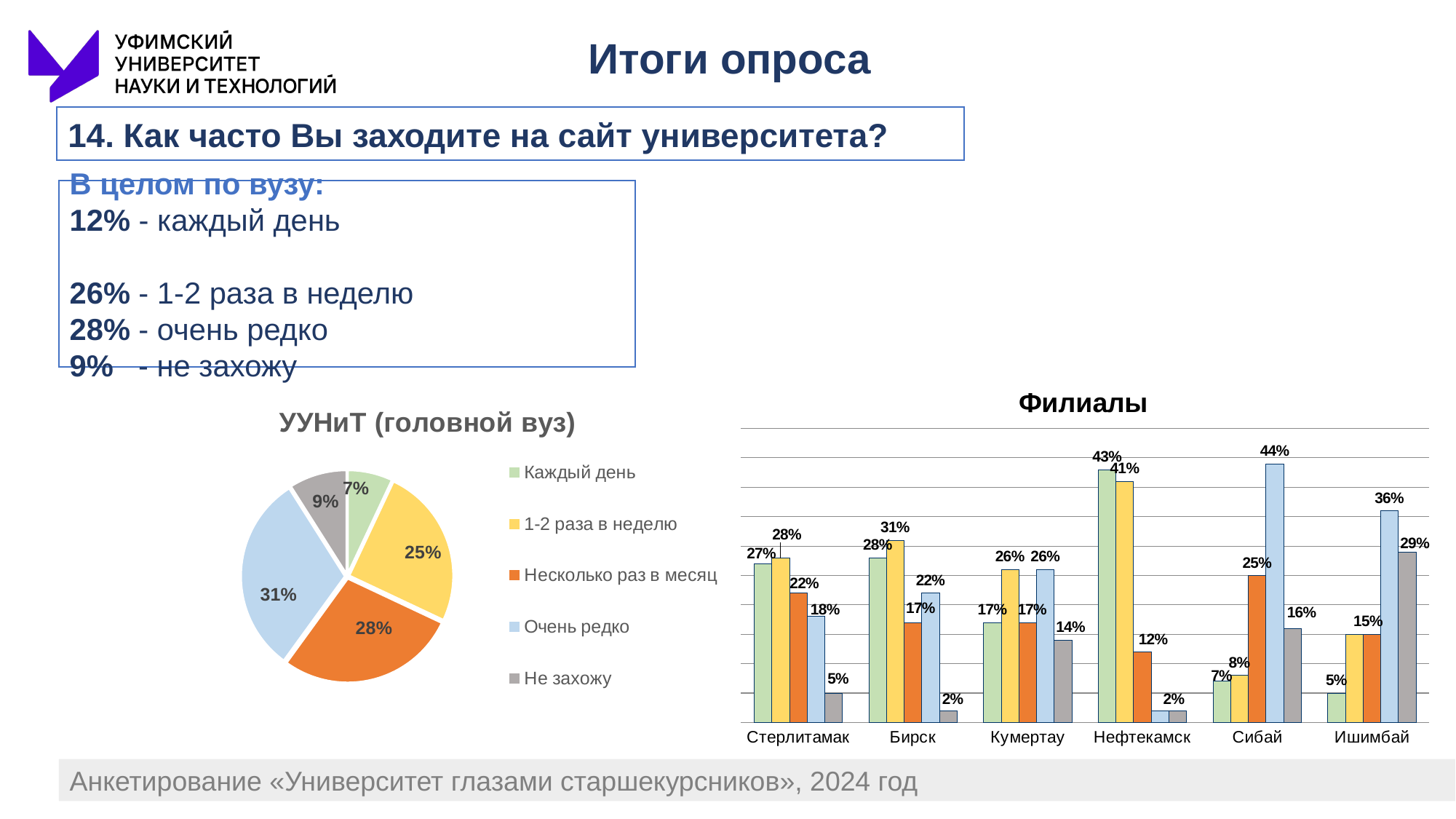
In the "Филиалы" chart, which is larger: the yellow "1-2 раза в неделю" bar for Бирск or for Стерлитамак? Бирск In the "УУНиТ (головной вуз)" pie chart, which category has the smallest slice? Каждый день What kind of chart is the "УУНиТ (головной вуз)" chart? pie chart How many branches (categories) are shown on the x axis of the "Филиалы" chart? 6 In the "Филиалы" chart, what is the value of the green "Каждый день" bar for Нефтекамск? 43% What kind of chart is the "Филиалы" chart? bar chart In the "Филиалы" chart, what is the difference between the light-blue "Очень редко" bars for Сибай (44%) and Ишимбай (36%)? 8 percentage points In the "УУНиТ (головной вуз)" pie chart, which category has the largest slice? Очень редко How many entries does the legend of the "УУНиТ (головной вуз)" chart list? 5 In the "Филиалы" chart, which branch has the tallest bar overall, and what is its value? Сибай, 44% In the "УУНиТ (головной вуз)" pie chart, what share does "Очень редко" have? 31% In the "УУНиТ (головной вуз)" pie chart, what is the value for "Каждый день"? 7%